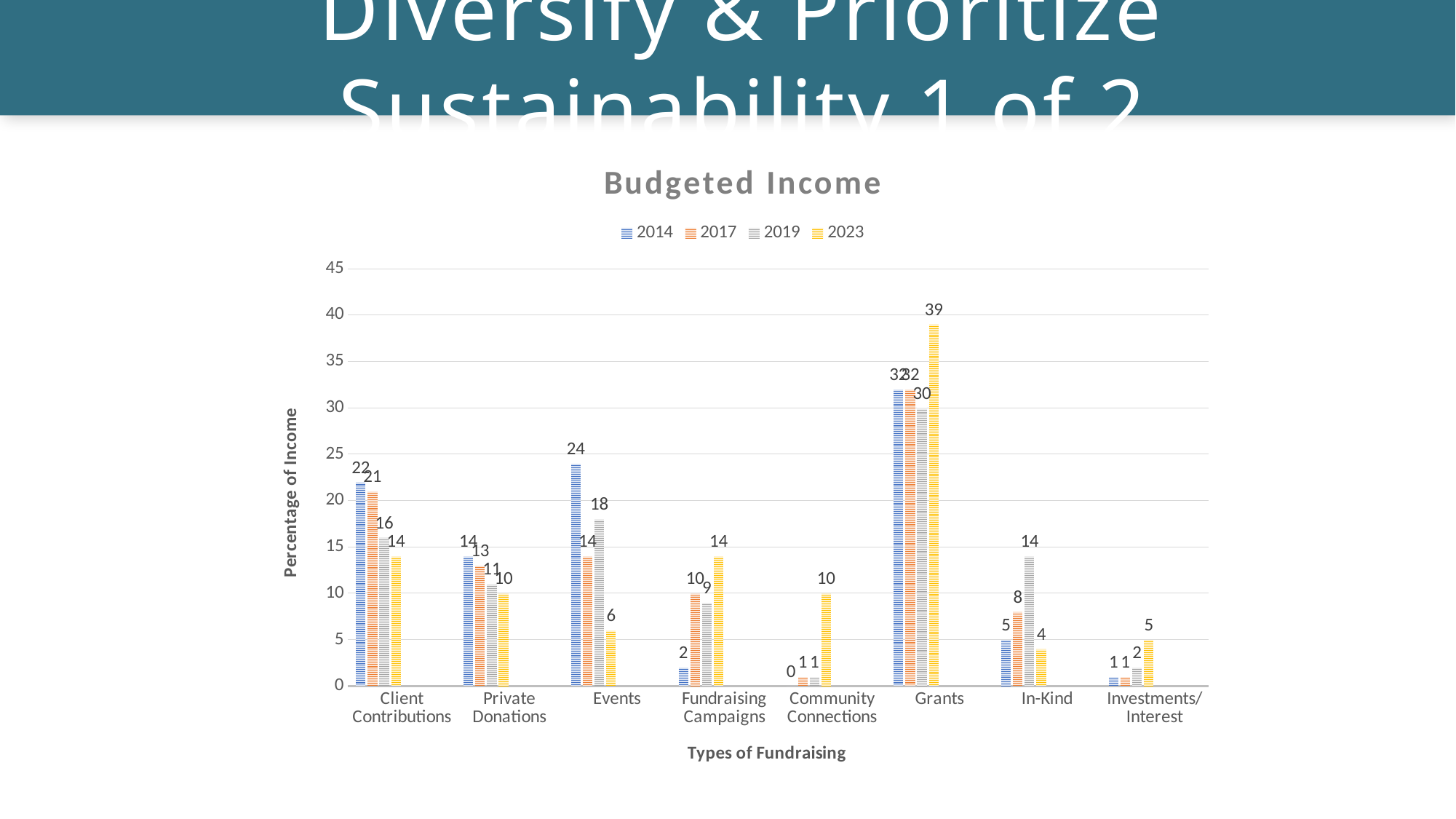
What is the title of the y axis? Percentage of Income Which type of fundraising has the highest value for 2023? Grants How many series does the legend list? 4 For Events, which year has the larger value, 2014 or 2019? 2014 What is the value for In-Kind in 2019? 14 What is the value for Events in 2014? 24 What is the value for Grants in 2023? 39 Which type of fundraising has the lowest value for 2014? Community Connections Do the values for Client Contributions rise or fall from 2014 to 2023? Fall What kind of chart is shown? Bar chart What is the difference between the 2023 and 2019 values for Grants? 9 How many types of fundraising are shown on the x axis? 8